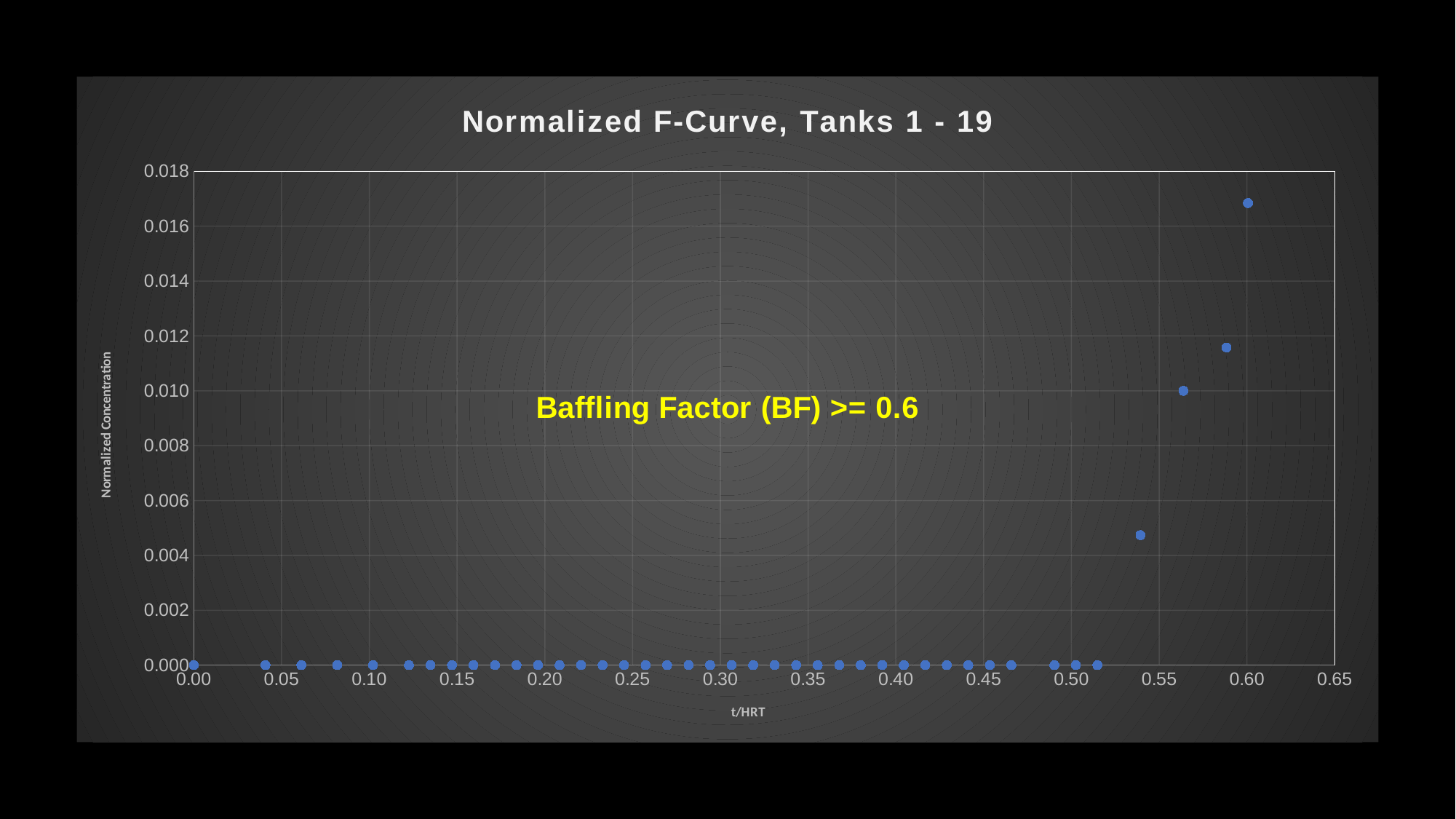
What is the title of the chart? Normalized F-Curve, Tanks 1 - 19 Is the value of the point near t/HRT 0.54 greater or less than 0.006? less Is the highest plotted point's value greater or less than 0.016? greater What is the label of the x axis? t/HRT Is the value of the point near t/HRT 0.54 greater or less than 0.004? greater Do the plotted values rise or fall as t/HRT increases beyond 0.50? rise How many plotted points have a value above 0.002? 4 Which point has the highest normalized concentration: the one near t/HRT 0.54 or the one near t/HRT 0.60? the one near t/HRT 0.60 Is the rightmost point higher or lower than the point near t/HRT 0.54? higher What kind of chart is shown on the slide? scatter chart